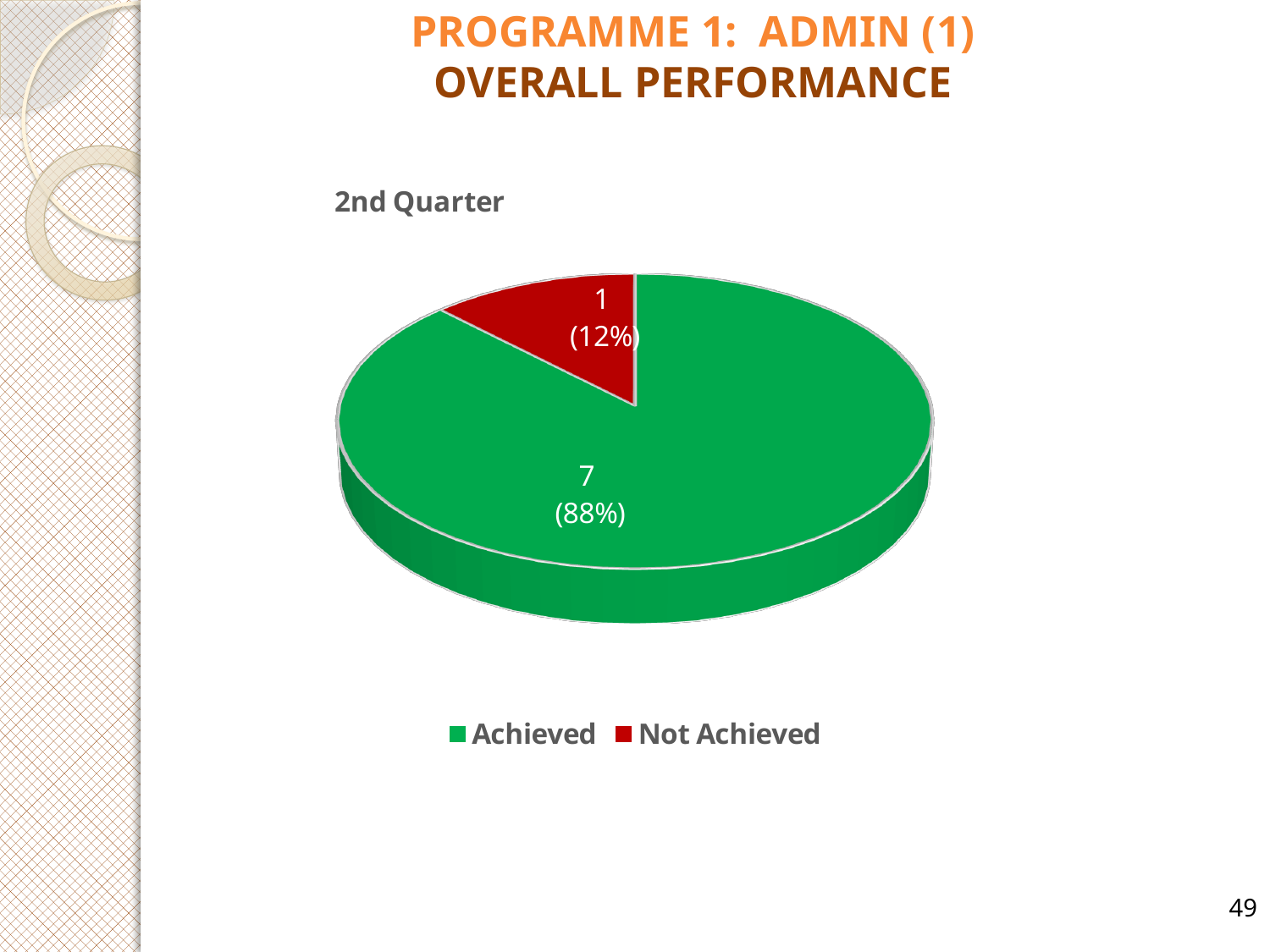
Which category has the smallest slice? Not Achieved What is the difference between the Achieved and Not Achieved values? 6 How many entries does the legend list? 2 What is the value for Not Achieved? 1 What kind of chart is shown on the slide? Pie chart What share of the pie does Not Achieved represent? 12% What share of the pie does Achieved represent? 88% What is the value for Achieved? 7 Which category has the largest slice? Achieved What colour is the Not Achieved slice? Red How many slices does the pie chart have? 2 What is the chart's title? 2nd Quarter